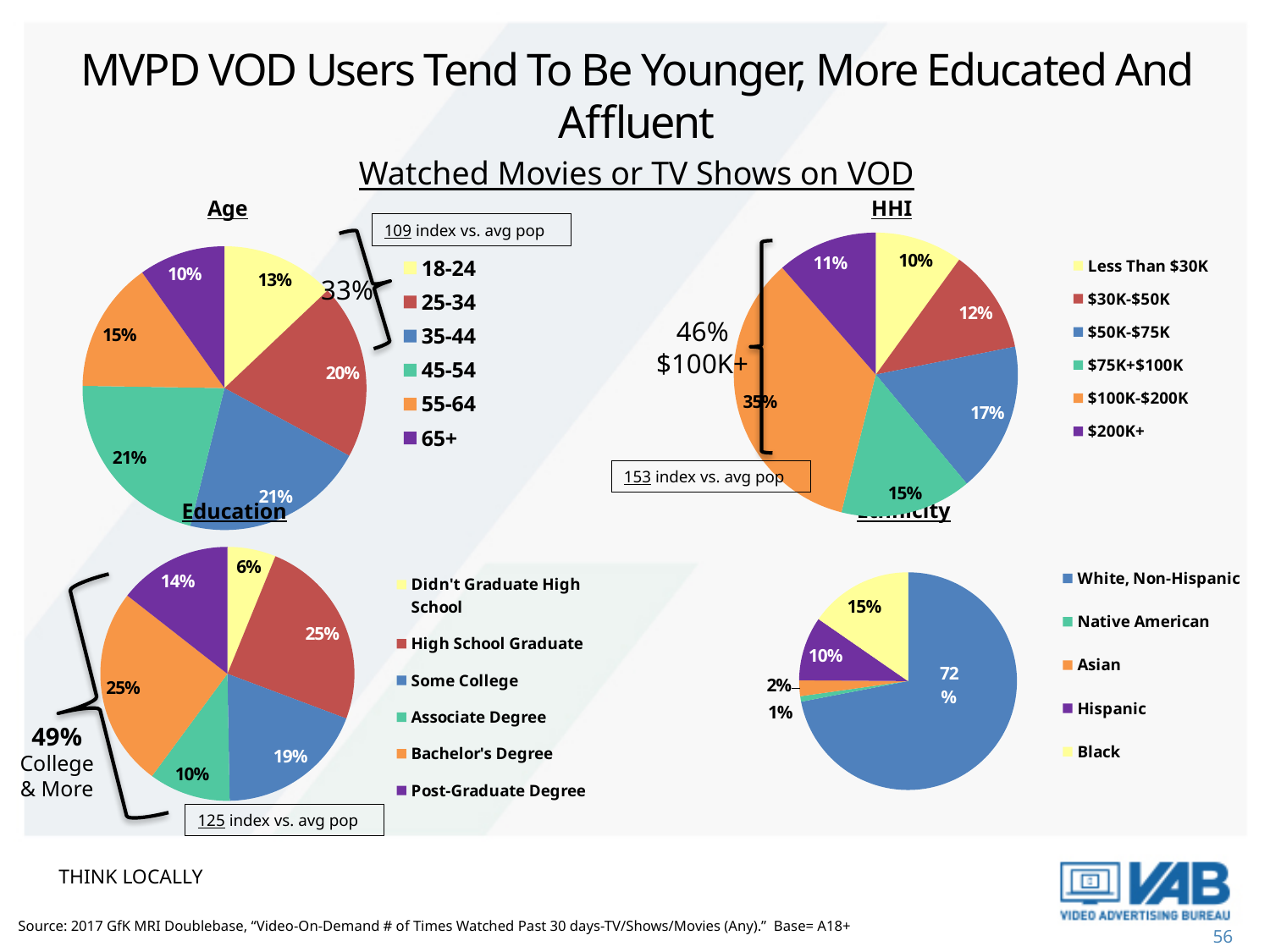
In the Ethnicity pie chart, what is the difference between the Black share and the Hispanic share? 5% In the Education pie chart, is the share for Some College larger or smaller than the share for Associate Degree? larger In the HHI pie chart, which income bracket has the largest share? $100K-$200K In the Age pie chart, what share of VOD users are aged 25-34? 20% In the Education pie chart, what share of VOD users have a Post-Graduate Degree? 14% In the Age pie chart, which age group has the smallest share? 65+ In the HHI pie chart, what share of VOD users have household income of $100K-$200K? 35% In the Ethnicity pie chart, what share of VOD users are White, Non-Hispanic? 72% What type of chart is used for the Ethnicity breakdown? pie chart In the Age pie chart, how many age categories does the legend list? 6 In the HHI pie chart, what is the difference between the $50K-$75K share and the $30K-$50K share? 5% In the Education pie chart, which category has the smallest share? Didn't Graduate High School